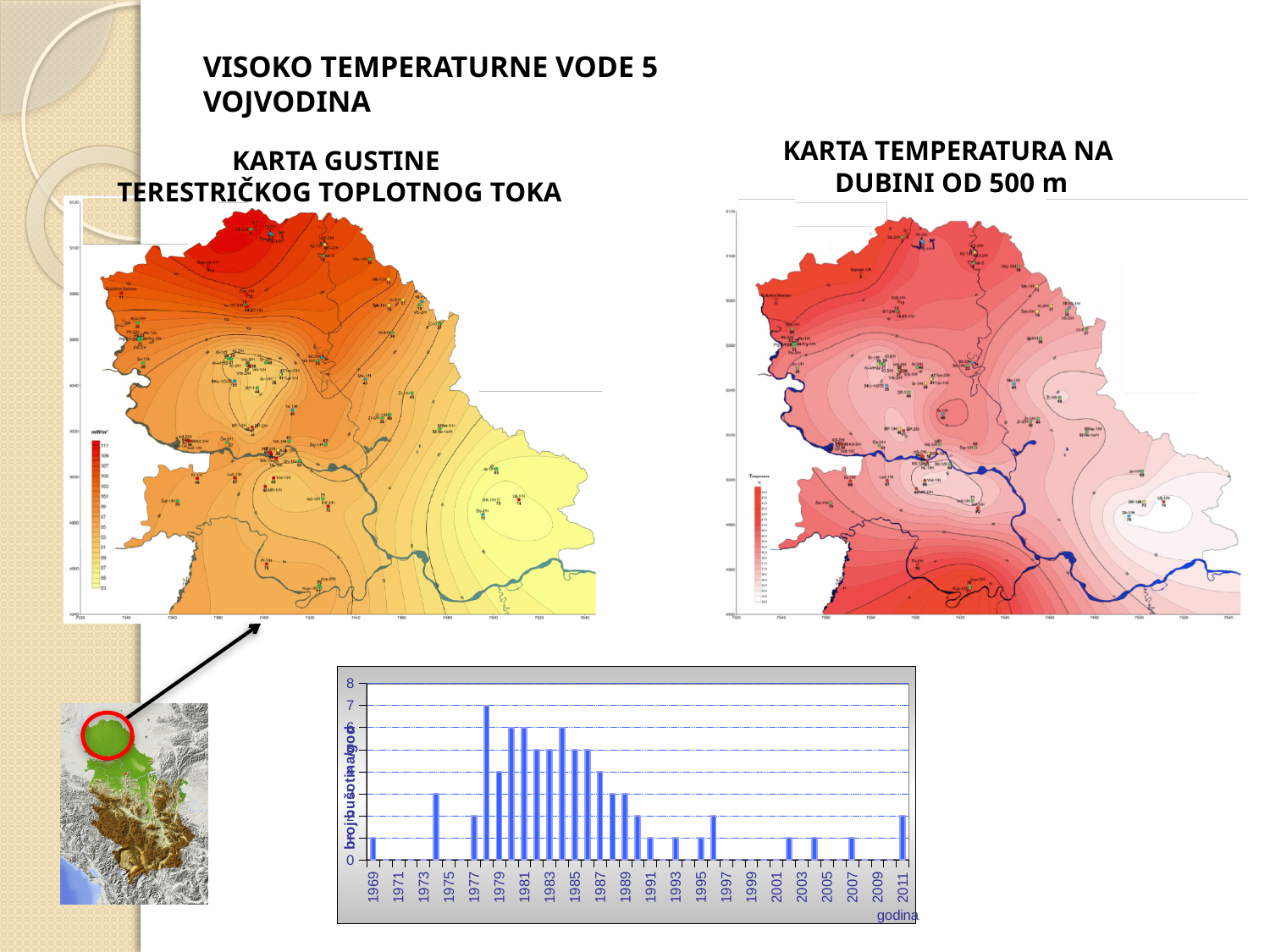
In the bar chart, what is the difference between the values for 1981 and 1969? 5 What is the label of the y axis of the bar chart? broj bušotina/god In the bar chart, what is the value for 1981? 6 In the bar chart, do the values rise or fall from 1981 to 1991? fall In the bar chart, what is the value for 1969? 1 In the bar chart, which is larger, the value for 1981 or the value for 1989? 1981 In the bar chart, what is the highest value reached by any bar? 7 In the bar chart, what is the value for 1979? 4 In the bar chart, is the value for 1983 greater or less than 4? greater How many year labels are shown on the x axis of the bar chart? 22 In the bar chart, what is the value for 2011? 2 What kind of chart is shown at the bottom of the slide? bar chart